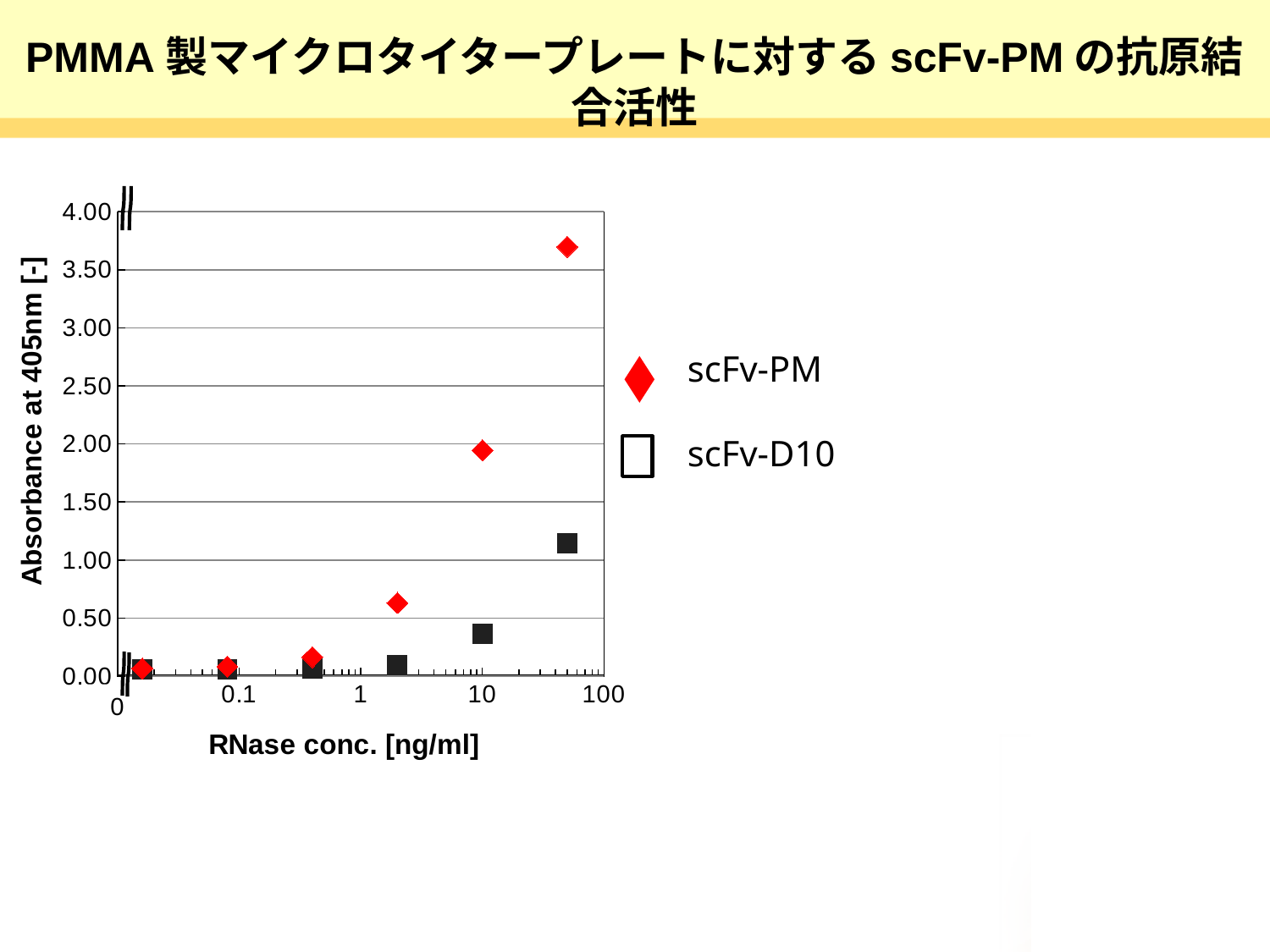
What is the title of the y axis? Absorbance at 405nm [-] Is the absorbance for scFv-PM at 10 ng/ml RNase greater or less than 1.50? greater Does the absorbance for scFv-PM rise or fall as RNase concentration increases? rise How many series does the legend list? 2 What kind of chart is shown on the slide? scatter chart How many data points are plotted for the scFv-PM series? 6 Is the absorbance for scFv-D10 at the highest RNase concentration greater or less than 1.50? less Is the absorbance for scFv-PM at the highest RNase concentration greater or less than 3.50? greater Which series is plotted with red diamond markers? scFv-PM At the highest RNase concentration, which series has the higher absorbance, scFv-PM or scFv-D10? scFv-PM